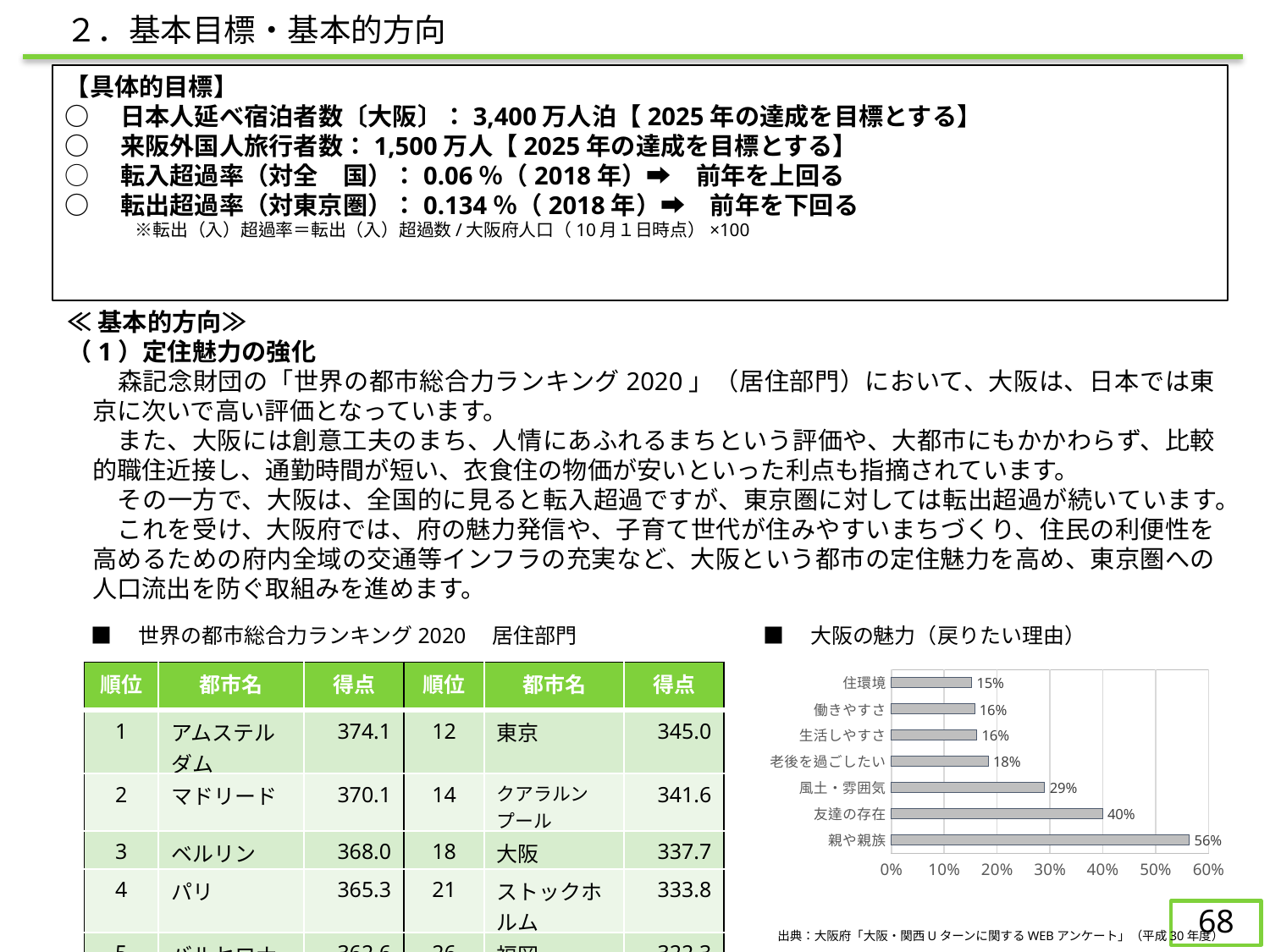
In the 大阪の魅力（戻りたい理由） chart, is the value for 親や親族 greater or less than 50%? greater What kind of chart is the 大阪の魅力（戻りたい理由） chart? bar chart What is the value for 風土・雰囲気 in the 大阪の魅力（戻りたい理由） chart? 29% How many categories are shown in the 大阪の魅力（戻りたい理由） chart? 7 What is the value for 親や親族 in the 大阪の魅力（戻りたい理由） chart? 56% What is the value for 老後を過ごしたい in the 大阪の魅力（戻りたい理由） chart? 18% Which category has the lowest value in the 大阪の魅力（戻りたい理由） chart? 住環境 In the 大阪の魅力（戻りたい理由） chart, what is the difference between 親や親族 and 友達の存在? 16% In the 大阪の魅力（戻りたい理由） chart, which is larger: 友達の存在 or 風土・雰囲気? 友達の存在 What is the value for 友達の存在 in the 大阪の魅力（戻りたい理由） chart? 40% In the 大阪の魅力（戻りたい理由） chart, what is the difference between 風土・雰囲気 and 住環境? 14% Which category has the highest value in the 大阪の魅力（戻りたい理由） chart? 親や親族